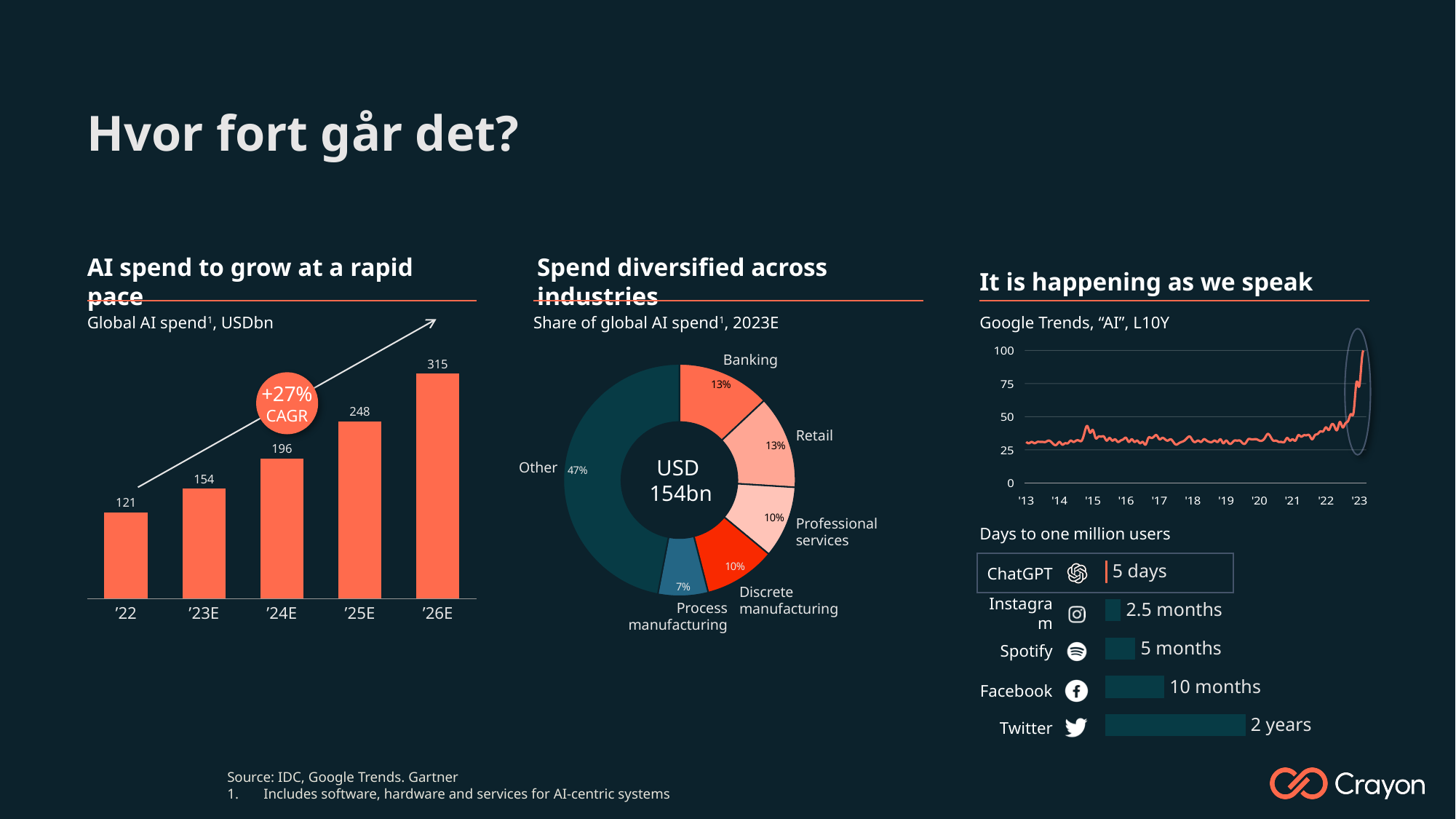
In the 'Global AI spend, USDbn' bar chart, what is the difference between the '26E and '22 values? 194 In the 'Global AI spend, USDbn' bar chart, how many bars are shown? 5 In the 'Global AI spend, USDbn' bar chart, do the values rise or fall from '22 to '26E? rise What total value is printed in the centre of the 'Share of global AI spend, 2023E' donut chart? USD 154bn In the 'Google Trends, "AI", L10Y' line chart, is the value for '15 greater or less than 50? less In the 'Share of global AI spend, 2023E' donut chart, which is larger: Retail or Professional services? Retail In the 'Share of global AI spend, 2023E' donut chart, what share does Process manufacturing have? 7% In the 'Global AI spend, USDbn' bar chart, which year has the highest value? '26E In the 'Days to one million users' chart, how long did ChatGPT take to reach one million users? 5 days In the 'Share of global AI spend, 2023E' donut chart, which category has the largest share? Other In the 'Global AI spend, USDbn' bar chart, what is the value for '24E? 196 What CAGR is shown in the 'Global AI spend, USDbn' bar chart? +27%